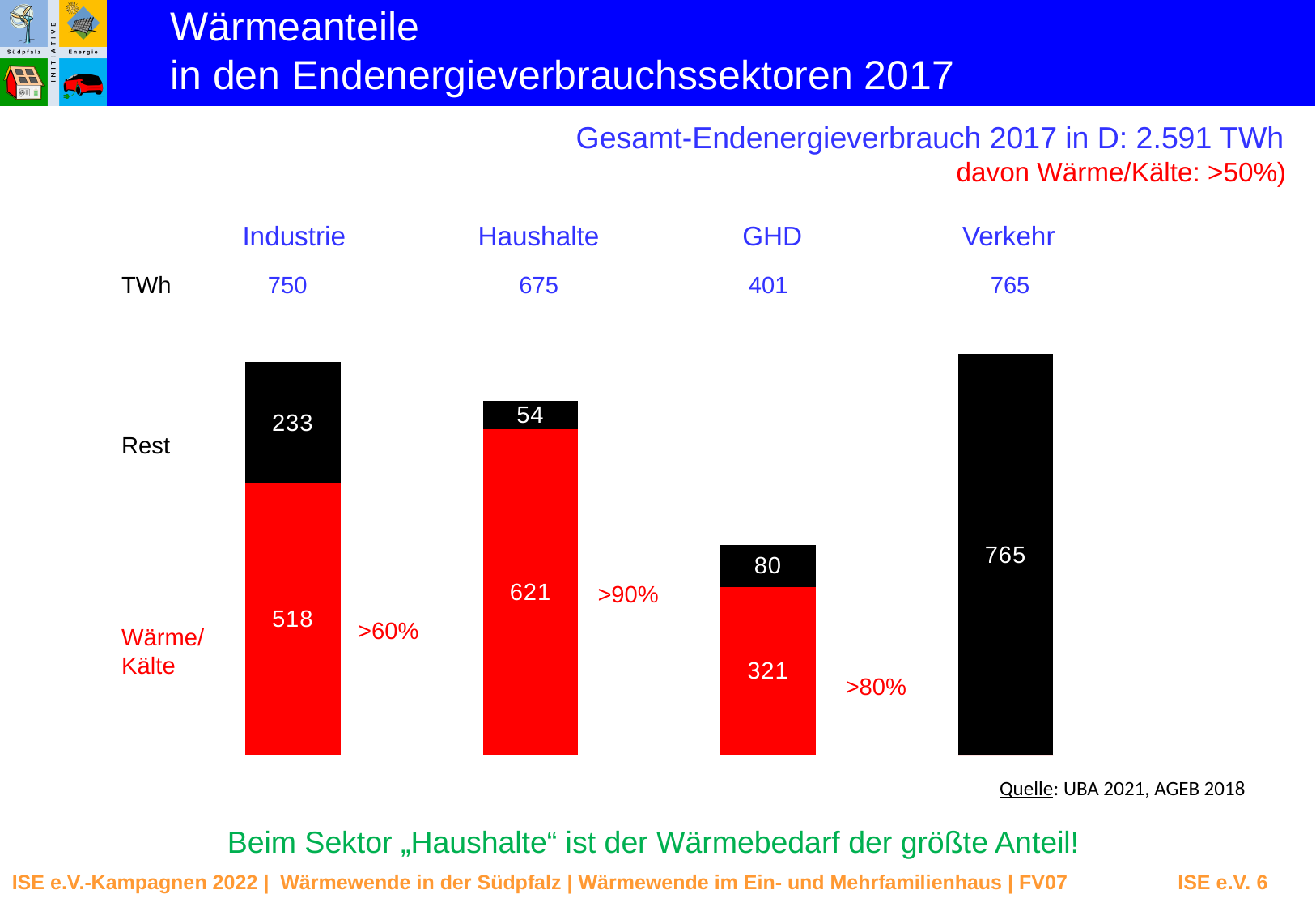
What kind of chart is shown on the slide? Stacked bar chart What is the total TWh value shown for Verkehr? 765 Which sector has the highest Wärme/Kälte value? Haushalte Which is larger, the Rest value for Industrie or the Rest value for GHD? Industrie How many sectors are shown in the chart? 4 What is the Wärme/Kälte value for Industrie? 518 What percentage share of Wärme/Kälte is indicated next to the Haushalte bar? >90% What is the Rest value for Haushalte? 54 What is the Wärme/Kälte value for GHD? 321 Which sector has the lowest total TWh value? GHD What is the difference between the Wärme/Kälte values for Industrie and GHD? 197 What is the total of the stacked bar for Industrie (Rest plus Wärme/Kälte)? 751